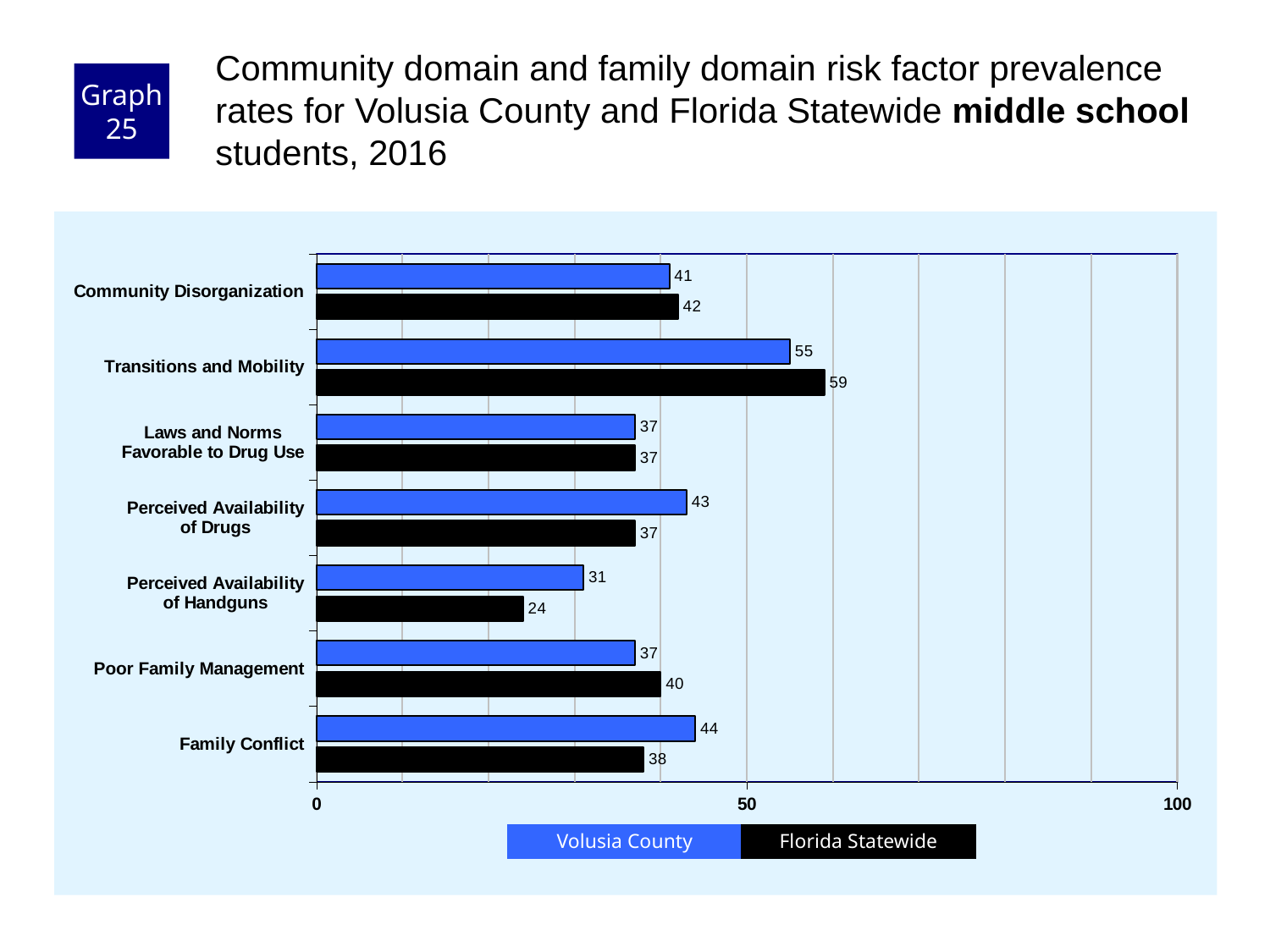
How many series does the legend list? 2 Which risk factor has the highest Florida Statewide value? Transitions and Mobility Is the Florida Statewide value for Transitions and Mobility greater or less than 50? greater Which risk factor has the lowest Volusia County value? Perceived Availability of Handguns What kind of chart is shown on the slide? bar chart Which colour represents Florida Statewide in the chart? black How many risk factor categories are shown on the chart? 7 For Perceived Availability of Drugs, which is larger: the Volusia County value or the Florida Statewide value? Volusia County What is the Volusia County value for Transitions and Mobility? 55 What is the Volusia County value for Family Conflict? 44 What is the Florida Statewide value for Perceived Availability of Handguns? 24 What is the difference between the Florida Statewide and Volusia County values for Transitions and Mobility? 4